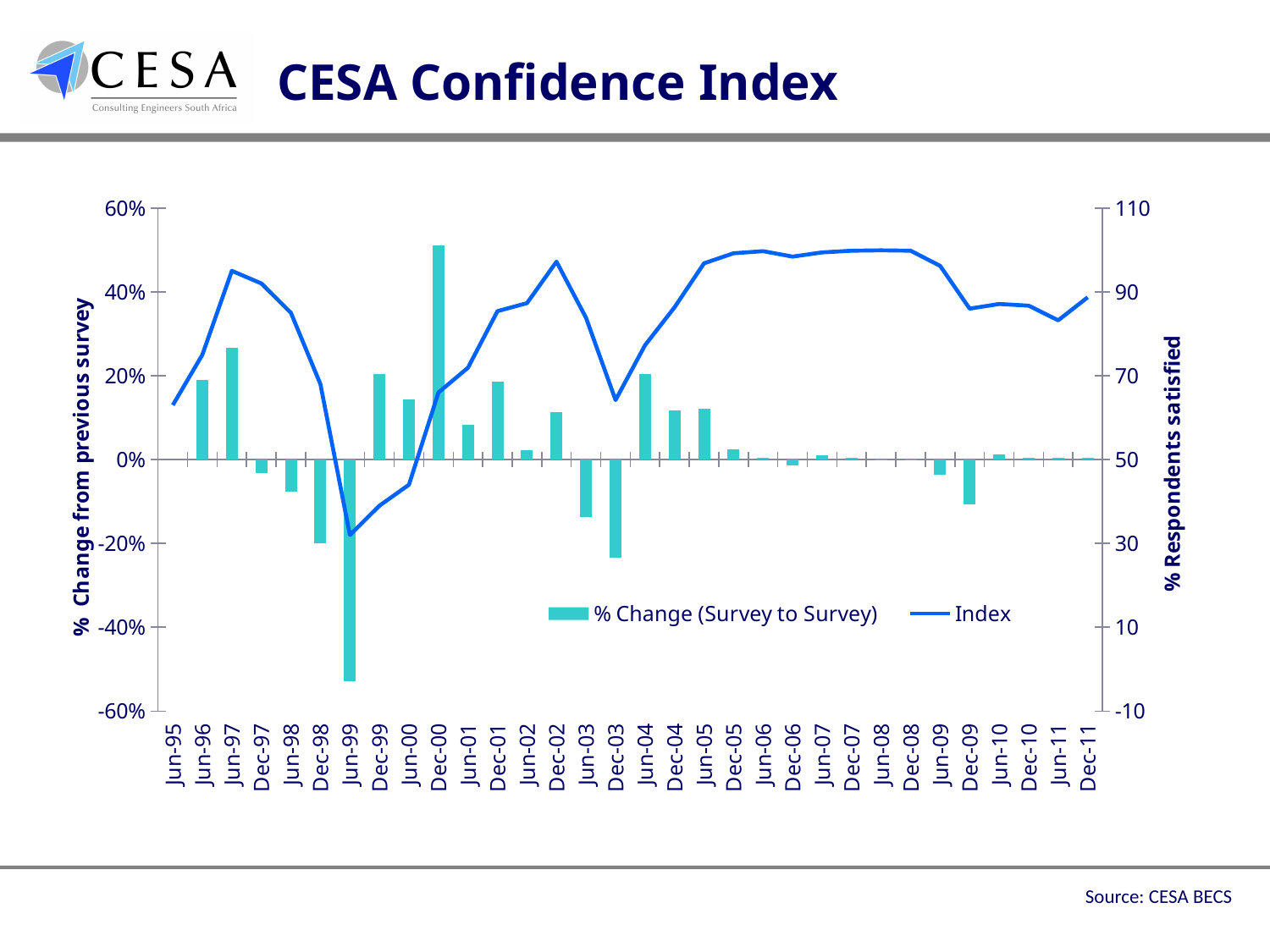
Does the Index line rise or fall from Dec-08 to Jun-11? It falls What kind of chart is shown on the slide? A combination bar and line chart How many series does the legend list? 2 Which survey period has the lowest bar for % Change (Survey to Survey)? Jun-99 What is the title of the right-hand vertical axis? % Respondents satisfied Which has the larger % Change bar, Jun-97 or Dec-00? Dec-00 Which survey period has the highest bar for % Change (Survey to Survey)? Dec-00 Is the % Change value for Dec-03 greater or less than -20%? less Is the % Change value for Jun-99 greater or less than -40%? less Is the Index value for Jun-99 greater or less than 50? less